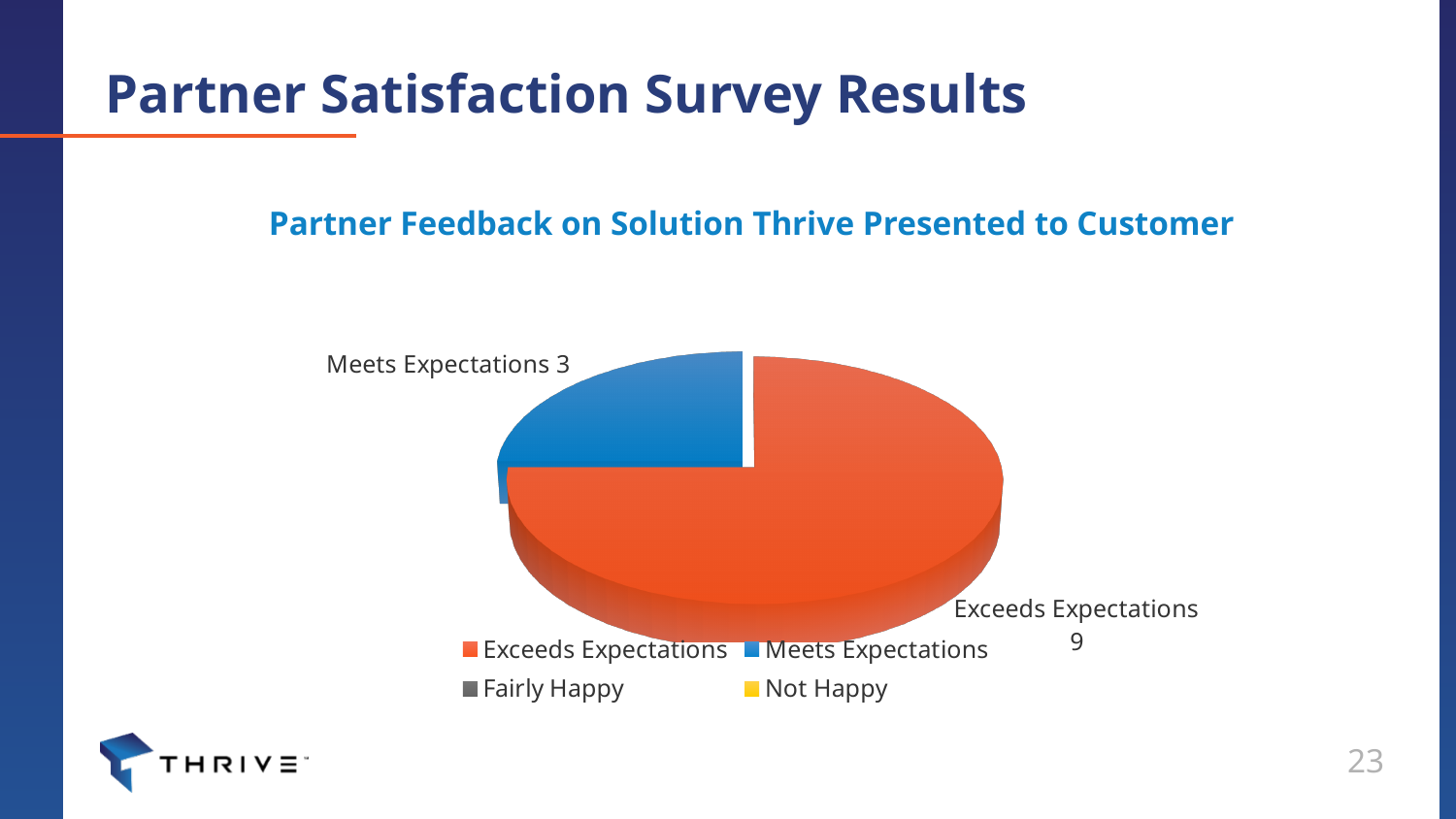
Which category has the largest slice of the pie? Exceeds Expectations Which is larger, the value for Exceeds Expectations or the value for Meets Expectations? Exceeds Expectations What type of chart is shown on the slide? Pie chart What is the value for Exceeds Expectations? 9 Which of the two labelled slices is smaller, Exceeds Expectations or Meets Expectations? Meets Expectations What colour is the Meets Expectations slice? Blue What share of the pie does Exceeds Expectations represent? 75% How many slices are visible in the pie chart? 2 What is the title of the chart? Partner Feedback on Solution Thrive Presented to Customer What is the value for Meets Expectations? 3 What is the difference between the Exceeds Expectations value and the Meets Expectations value? 6 How many entries does the legend list? 4